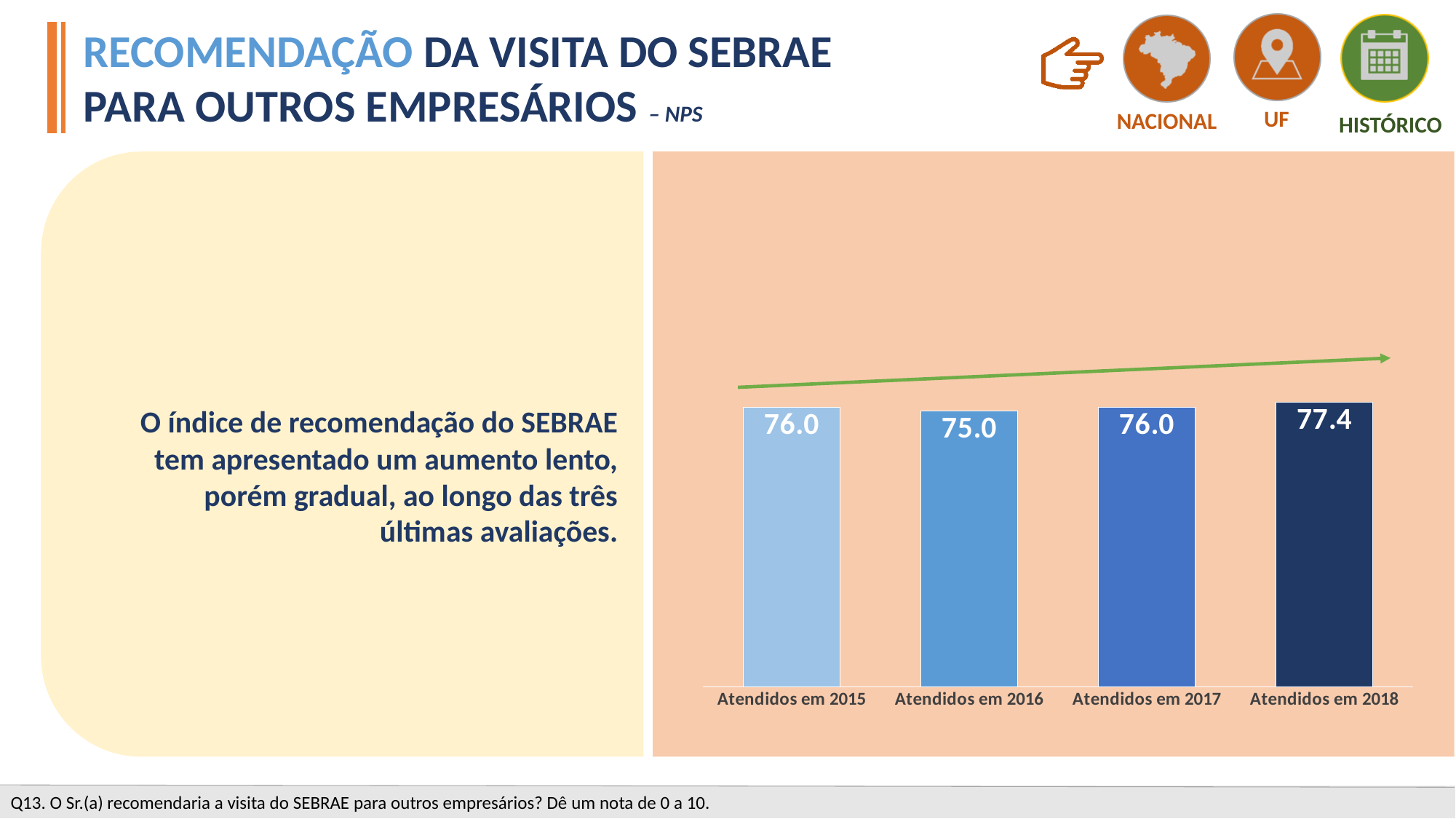
What is the value for Atendidos em 2015? 76.0 Which is larger, the value for Atendidos em 2016 or Atendidos em 2018? Atendidos em 2018 What is the difference between the values for Atendidos em 2018 and Atendidos em 2016? 2.4 Which category has the lowest value? Atendidos em 2016 How many categories are shown in the chart? 4 Which category has the highest value? Atendidos em 2018 What is the value for Atendidos em 2017? 76.0 Do the values rise or fall from Atendidos em 2016 to Atendidos em 2018? Rise What is the difference between the values for Atendidos em 2018 and Atendidos em 2017? 1.4 What is the value for Atendidos em 2018? 77.4 What is the value for Atendidos em 2016? 75.0 What kind of chart is shown on the slide? Bar chart